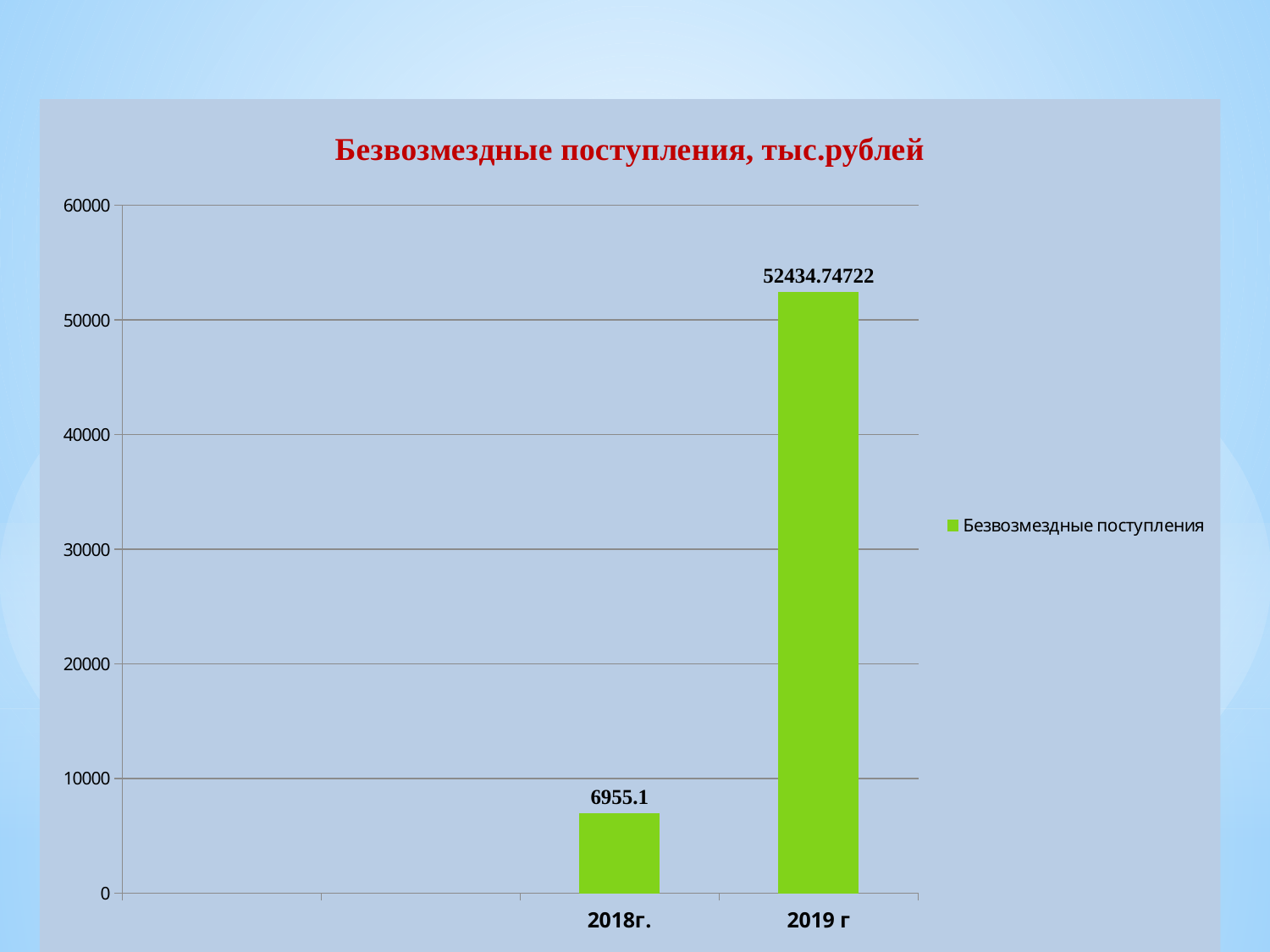
How many series does the legend list? 1 What is the value for 2018г.? 6955.1 Which year has the highest value? 2019 г How many categories are shown on the x axis? 2 Which year has the lowest value? 2018г. What is the value for 2019 г? 52434.74722 What is the title of the chart? Безвозмездные поступления, тыс.рублей What kind of chart is shown? bar chart Is the value for 2018г. greater or less than 10000? less Is the value for 2019 г greater or less than 50000? greater Which is larger, the value for 2018г. or the value for 2019 г? 2019 г What is the difference between the values for 2019 г and 2018г.? 45479.64722